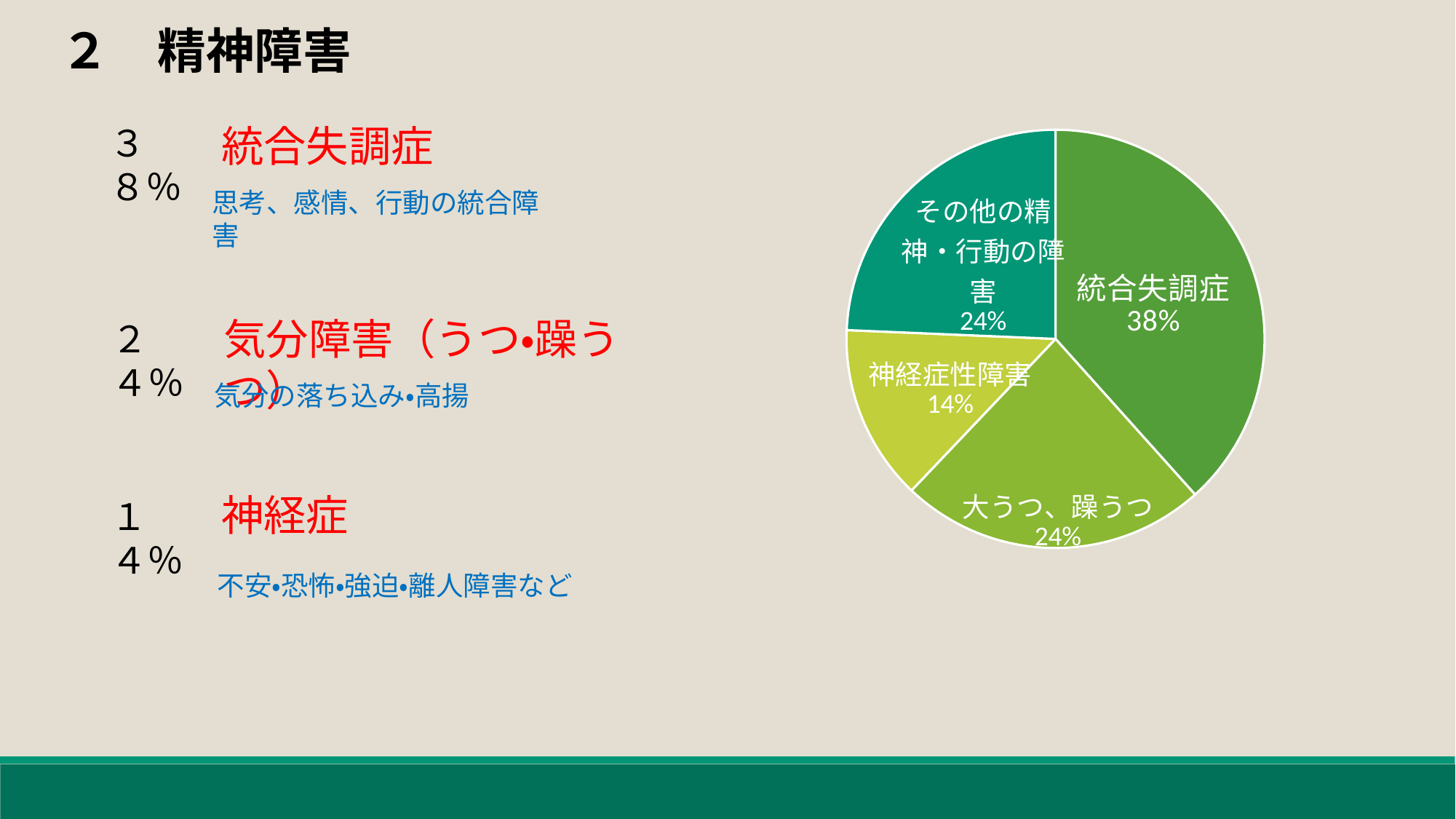
What percentage does the 神経症性障害 slice show? 14% What percentage does the 統合失調症 slice show? 38% What percentage does the 大うつ、躁うつ slice show? 24% What is the difference in percentage points between the 統合失調症 slice and the 神経症性障害 slice? 24 Which is larger, the 統合失調症 slice or the 大うつ、躁うつ slice? 統合失調症 What percentage does the その他の精神・行動の障害 slice show? 24% Which slice of the pie chart is the smallest? 神経症性障害 Is the 統合失調症 slice greater or less than 30%? greater Which slice of the pie chart is the largest? 統合失調症 What kind of chart is shown on the slide? pie chart What is the combined percentage of the 大うつ、躁うつ and 神経症性障害 slices? 38% How many slices does the pie chart have? 4